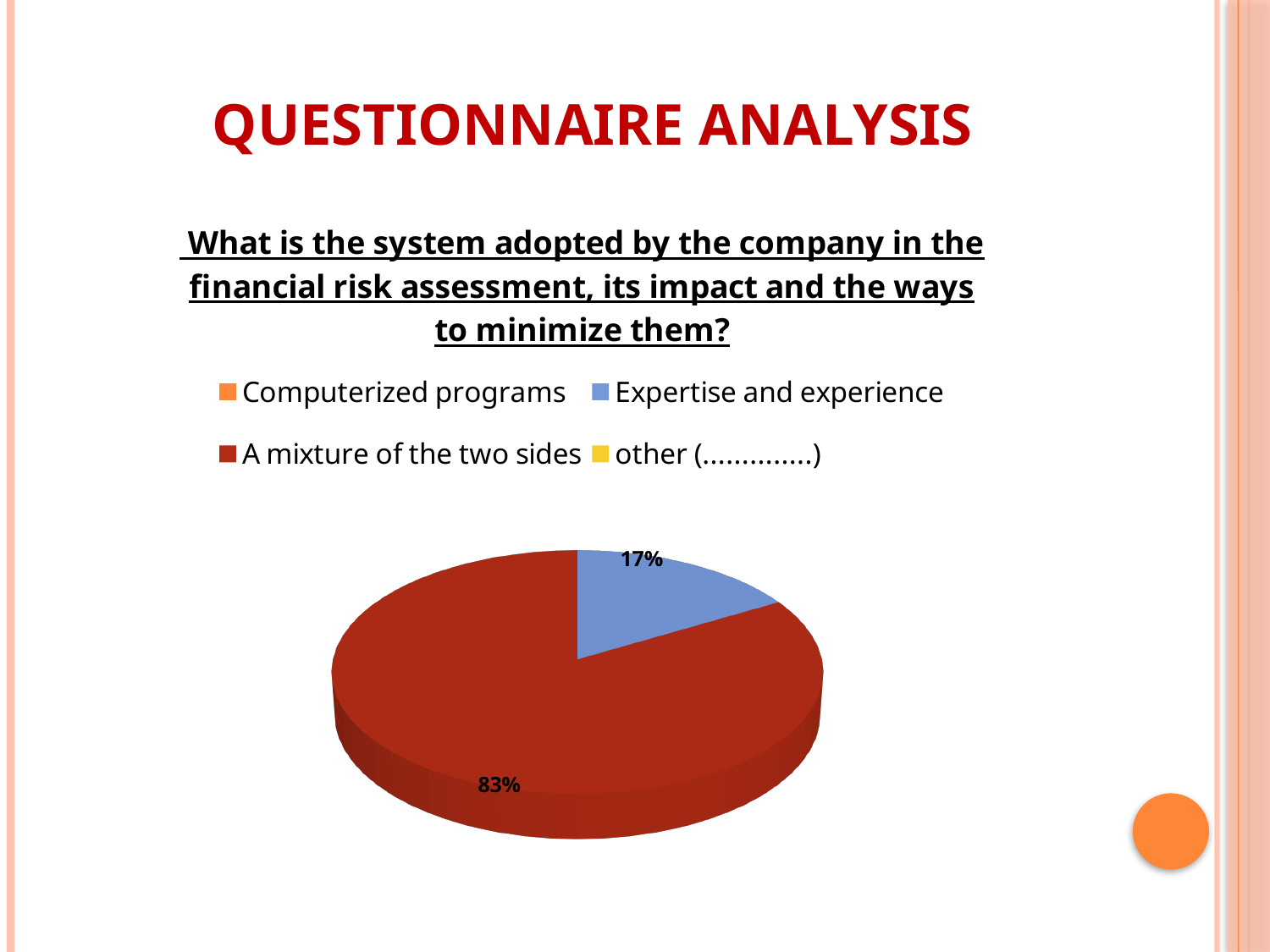
What colour is the slice for 'A mixture of the two sides'? Red What share of the pie does 'Expertise and experience' represent? 17% What kind of chart is shown on the slide? Pie chart What is the total of the two labelled slices in the pie chart? 100% How many slices with data labels are visible in the pie chart? 2 How many entries does the chart legend list? 4 What colour is the slice for 'Expertise and experience'? Blue Which of the two labelled slices is larger: 'Expertise and experience' or 'A mixture of the two sides'? A mixture of the two sides What share of the pie does 'A mixture of the two sides' represent? 83% What is the difference in percentage points between the 'A mixture of the two sides' slice and the 'Expertise and experience' slice? 66 percentage points Which category has the largest slice of the pie? A mixture of the two sides